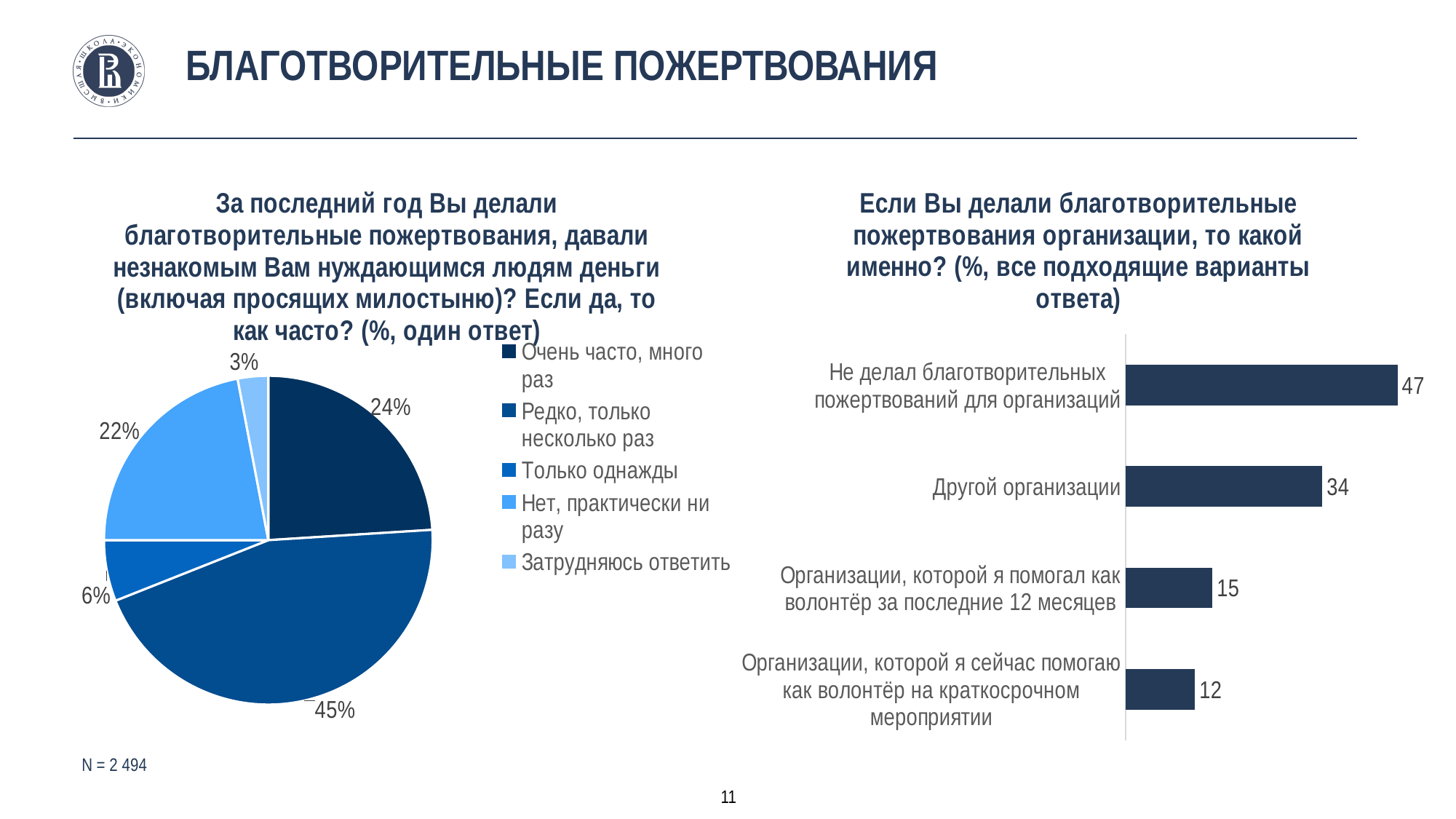
In the pie chart on the left, what share of respondents answered "Очень часто, много раз"? 24% In the pie chart on the left, which answer has the smallest share? Затрудняюсь ответить In the bar chart on the right, which category has the highest value? Не делал благотворительных пожертвований для организаций In the bar chart on the right, which is larger: the value for "Организации, которой я помогал как волонтёр за последние 12 месяцев" or for "Организации, которой я сейчас помогаю как волонтёр на краткосрочном мероприятии"? Организации, которой я помогал как волонтёр за последние 12 месяцев In the pie chart on the left, how many entries does the legend list? 5 What type of chart is shown on the right side of the slide? Bar chart In the bar chart on the right, how many categories are shown? 4 In the bar chart on the right, what is the value for "Другой организации"? 34 In the pie chart on the left, what share of respondents answered "Редко, только несколько раз"? 45% In the pie chart on the left, what is the difference in percentage points between "Нет, практически ни разу" and "Только однажды"? 16 In the bar chart on the right, what is the difference between the values for "Не делал благотворительных пожертвований для организаций" and "Другой организации"? 13 In the pie chart on the left, which answer has the largest share? Редко, только несколько раз